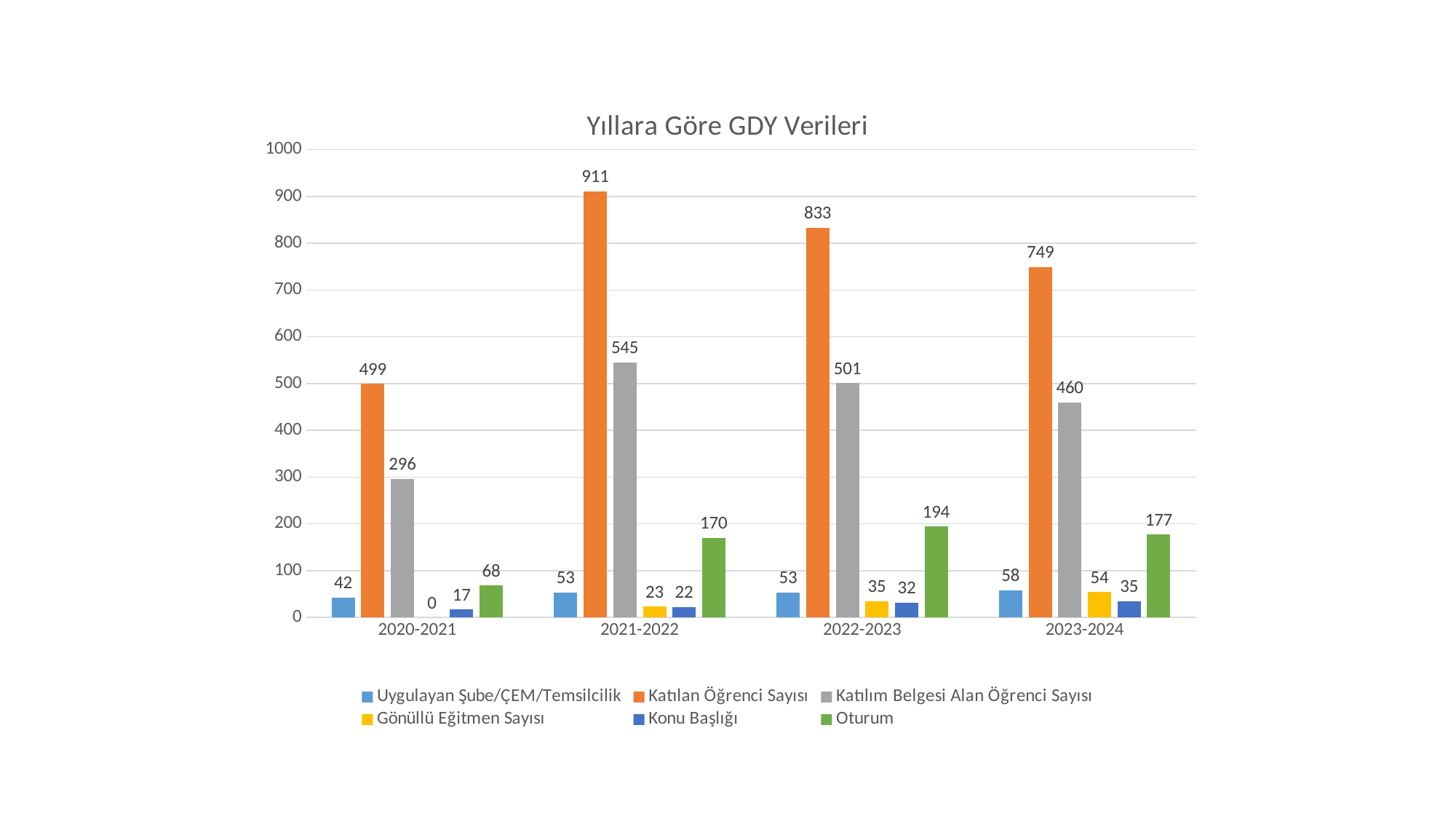
What is the value of Oturum for 2022-2023? 194 In which year is Oturum lowest? 2020-2021 What is the value of Katılan Öğrenci Sayısı for 2021-2022? 911 In which year is Katılan Öğrenci Sayısı highest? 2021-2022 What is the value of Gönüllü Eğitmen Sayısı for 2020-2021? 0 What is the value of Katılım Belgesi Alan Öğrenci Sayısı for 2023-2024? 460 What is the title of the chart? Yıllara Göre GDY Verileri How many year categories are shown on the x axis? 4 How many series does the legend list? 6 Which is larger in 2023-2024: Gönüllü Eğitmen Sayısı or Konu Başlığı? Gönüllü Eğitmen Sayısı What kind of chart is shown? Bar chart What is the difference between Katılan Öğrenci Sayısı and Katılım Belgesi Alan Öğrenci Sayısı in 2022-2023? 332